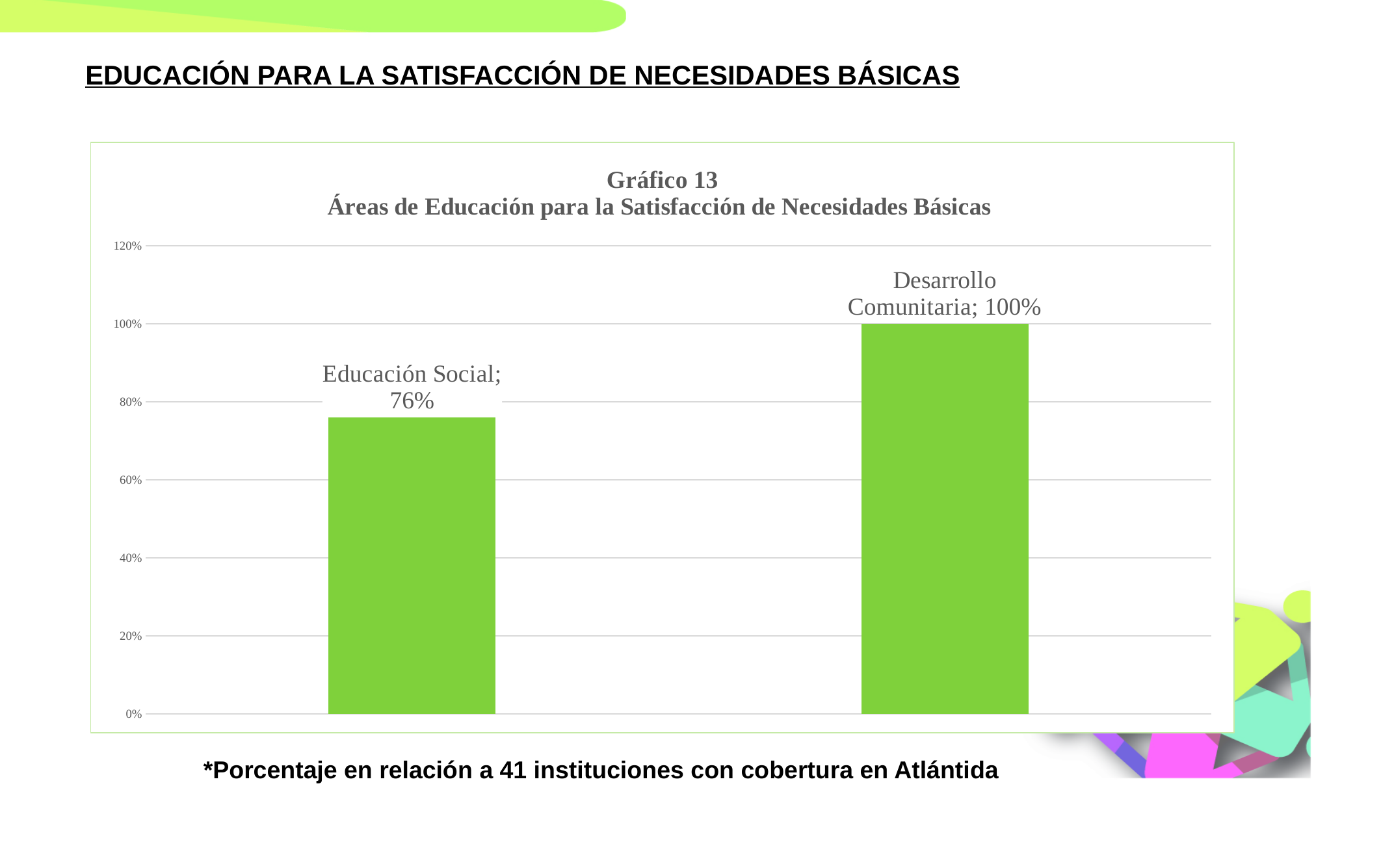
Is the value for Educación Social greater or less than 80%? less What is the difference between the values for Desarrollo Comunitaria and Educación Social? 24% Which category has the highest value? Desarrollo Comunitaria What is the chart number given in the chart title? Gráfico 13 What kind of chart is shown on the slide? bar chart Which category has the lowest value? Educación Social Which is larger, the value for Educación Social or the value for Desarrollo Comunitaria? Desarrollo Comunitaria What colour are the bars in the chart? green How many categories are shown in the chart? 2 What is the value for Educación Social? 76% Do the values rise or fall from left to right along the x axis? rise What is the value for Desarrollo Comunitaria? 100%